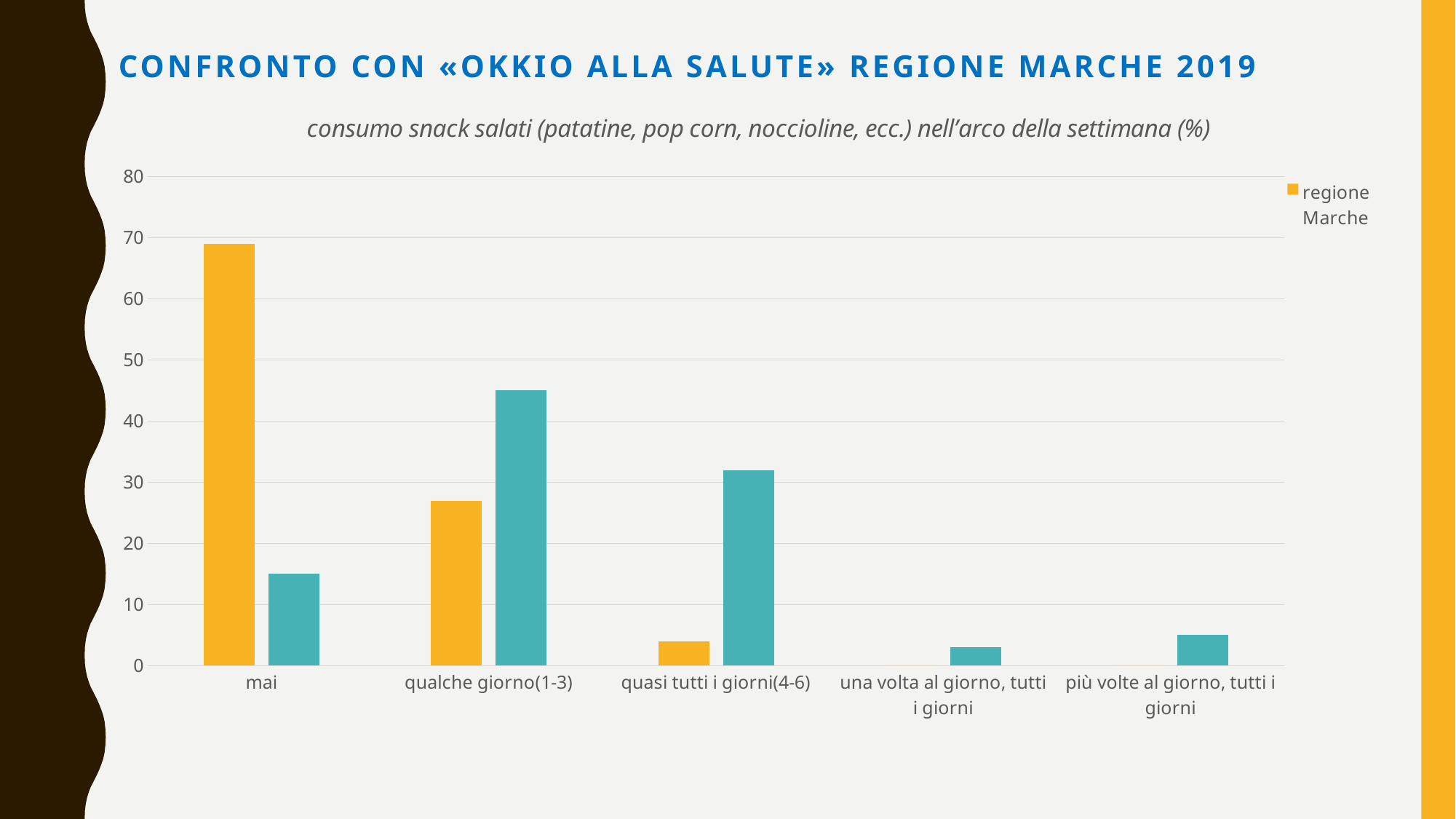
What is the name of the series listed in the legend? regione Marche Is the teal bar for 'mai' greater or less than 10? greater How many categories are shown on the x axis of the chart? 5 Is the teal bar for 'qualche giorno(1-3)' greater or less than 40? greater Do the regione Marche values rise or fall moving from 'mai' to 'quasi tutti i giorni(4-6)' along the x axis? fall What kind of chart is shown on the slide? bar chart Which category has the highest value for the regione Marche series? mai What is the title of the chart? consumo snack salati (patatine, pop corn, noccioline, ecc.) nell'arco della settimana (%) How many series does the chart's legend list? 1 Is the regione Marche value for 'qualche giorno(1-3)' greater or less than 30? less For 'qualche giorno(1-3)', which bar is larger: the yellow regione Marche bar or the teal bar? the teal bar